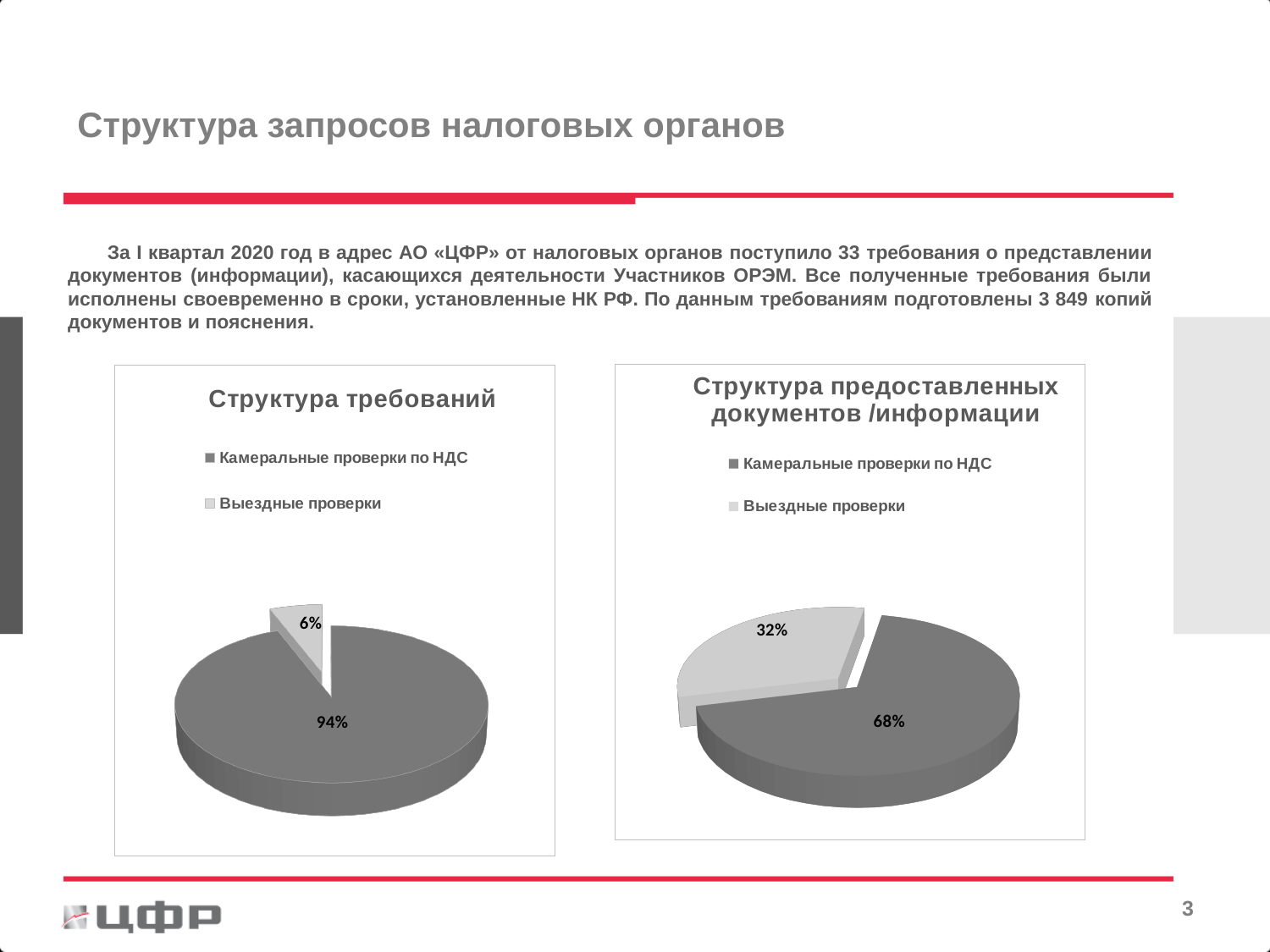
In the chart titled "Структура требований", what share is labelled for Камеральные проверки по НДС? 94% In the chart titled "Структура предоставленных документов /информации", what is the difference in percentage points between Камеральные проверки по НДС and Выездные проверки? 36 In the chart titled "Структура требований", what is the difference in percentage points between the two slices? 88 In the chart titled "Структура предоставленных документов /информации", which is larger: Камеральные проверки по НДС or Выездные проверки? Камеральные проверки по НДС What type of chart is the left chart titled "Структура требований"? Pie chart In the chart titled "Структура требований", what share is labelled for Выездные проверки? 6% What is the title of the right-hand chart on the slide? Структура предоставленных документов /информации In the chart titled "Структура предоставленных документов /информации", what share is labelled for Выездные проверки? 32% In the chart titled "Структура предоставленных документов /информации", which category has the smallest slice? Выездные проверки In the chart titled "Структура требований", which category has the largest slice? Камеральные проверки по НДС How many categories does the legend of the chart titled "Структура требований" list? 2